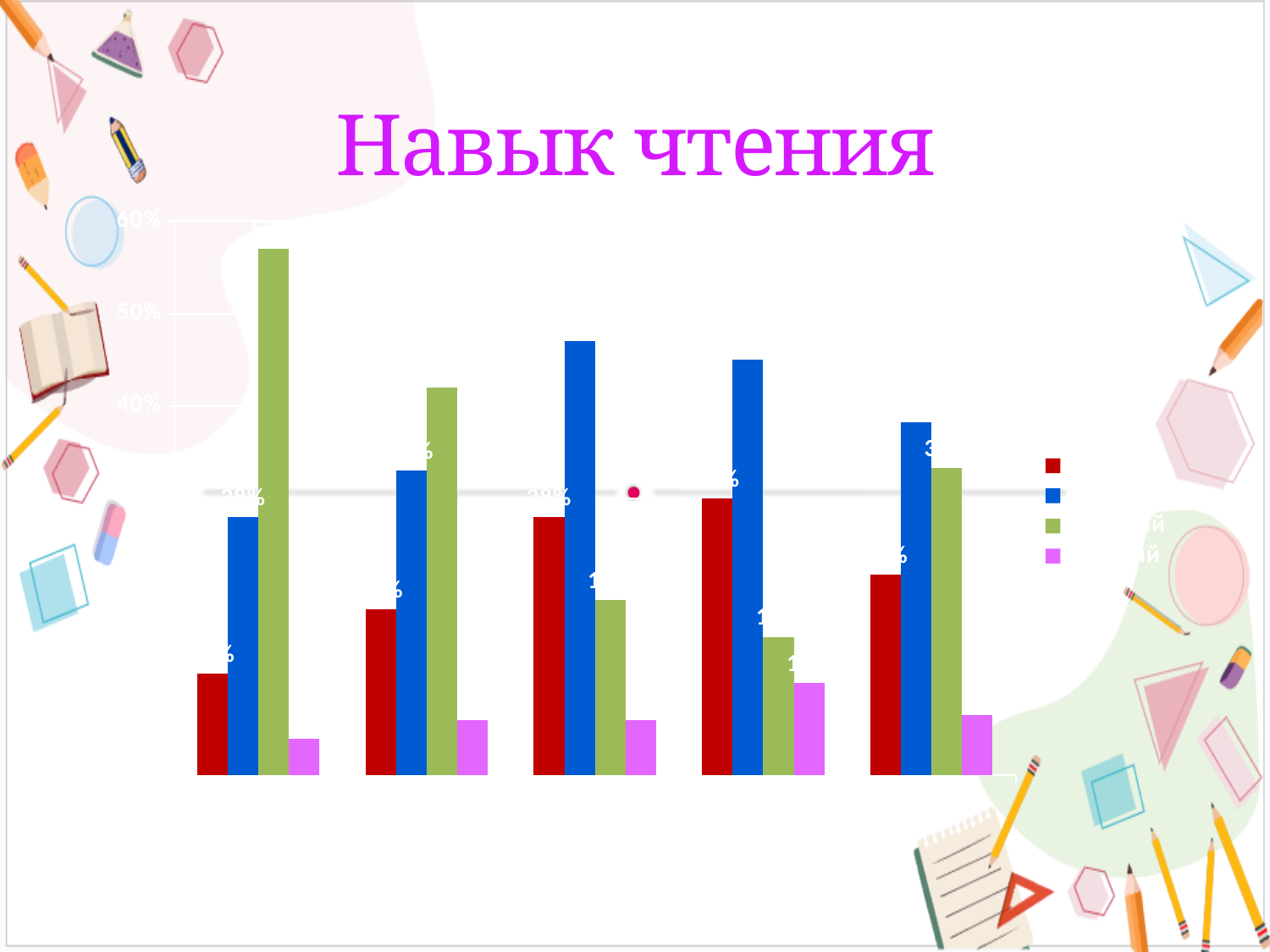
Does the tallest bar in the chart reach above 50% on the vertical axis? Yes What kind of chart is shown on the slide? bar chart How many series does the chart's legend list? 4 What colours are the four series in the chart's legend, from top to bottom? red, blue, green, magenta How many groups of bars (categories) are plotted in the chart? 5 What is the title of the chart on the slide? Навык чтения